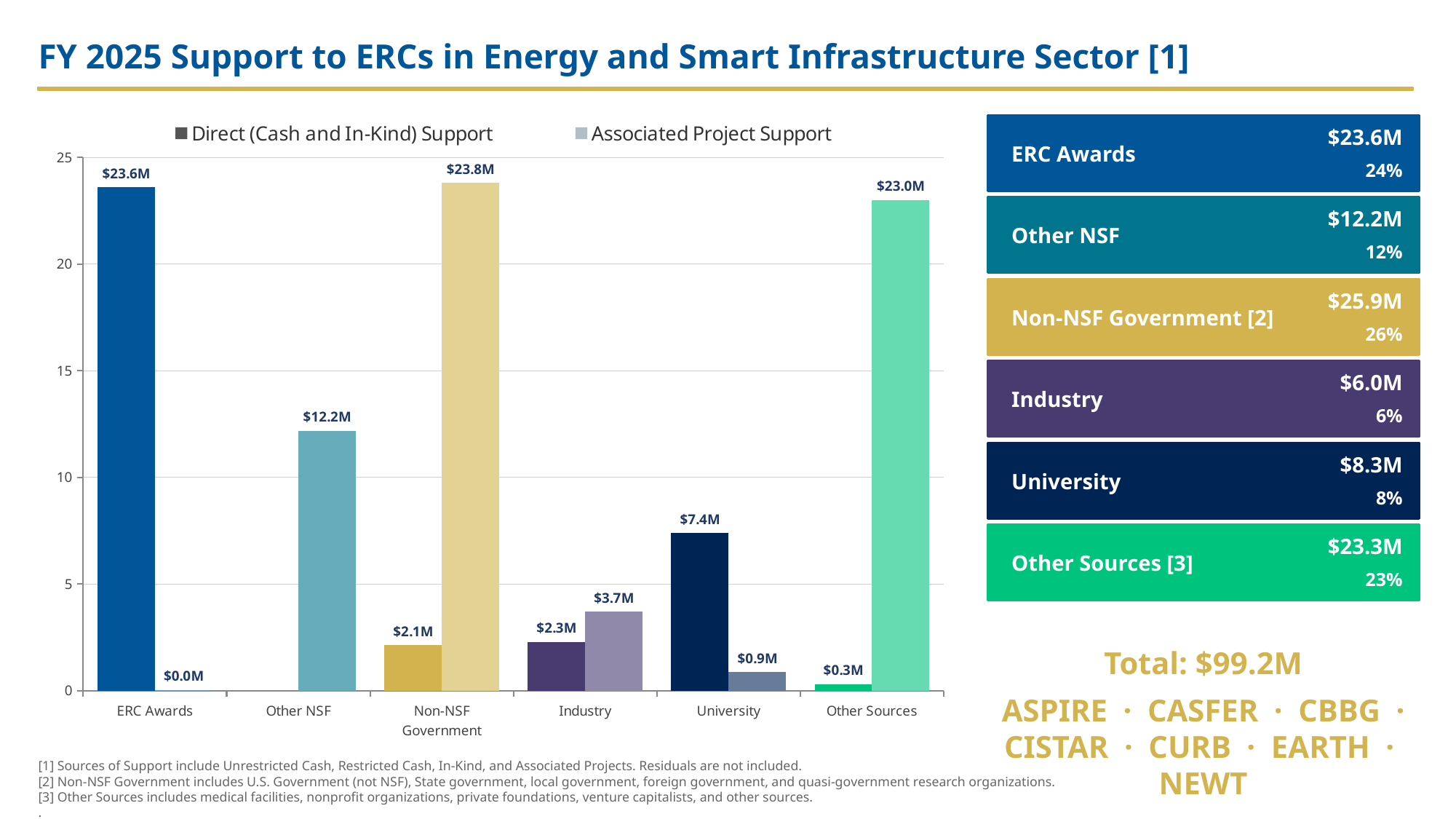
What is the Associated Project Support value for Industry? $3.7M What is the Associated Project Support value for Non-NSF Government? $23.8M What is the Direct (Cash and In-Kind) Support value for ERC Awards? $23.6M How many categories are shown along the x axis of the chart? 6 What kind of chart is shown on the slide? Bar chart What is the difference between the Associated Project Support and Direct (Cash and In-Kind) Support values for Industry? $1.4M How many series does the chart legend list? 2 For University, which is larger: Direct (Cash and In-Kind) Support or Associated Project Support? Direct (Cash and In-Kind) Support What is the Direct (Cash and In-Kind) Support value for University? $7.4M Which category has the highest Associated Project Support value? Non-NSF Government Is the Associated Project Support value for Other Sources greater or less than 20? greater What is the difference between the Direct (Cash and In-Kind) Support values for ERC Awards and University? $16.2M